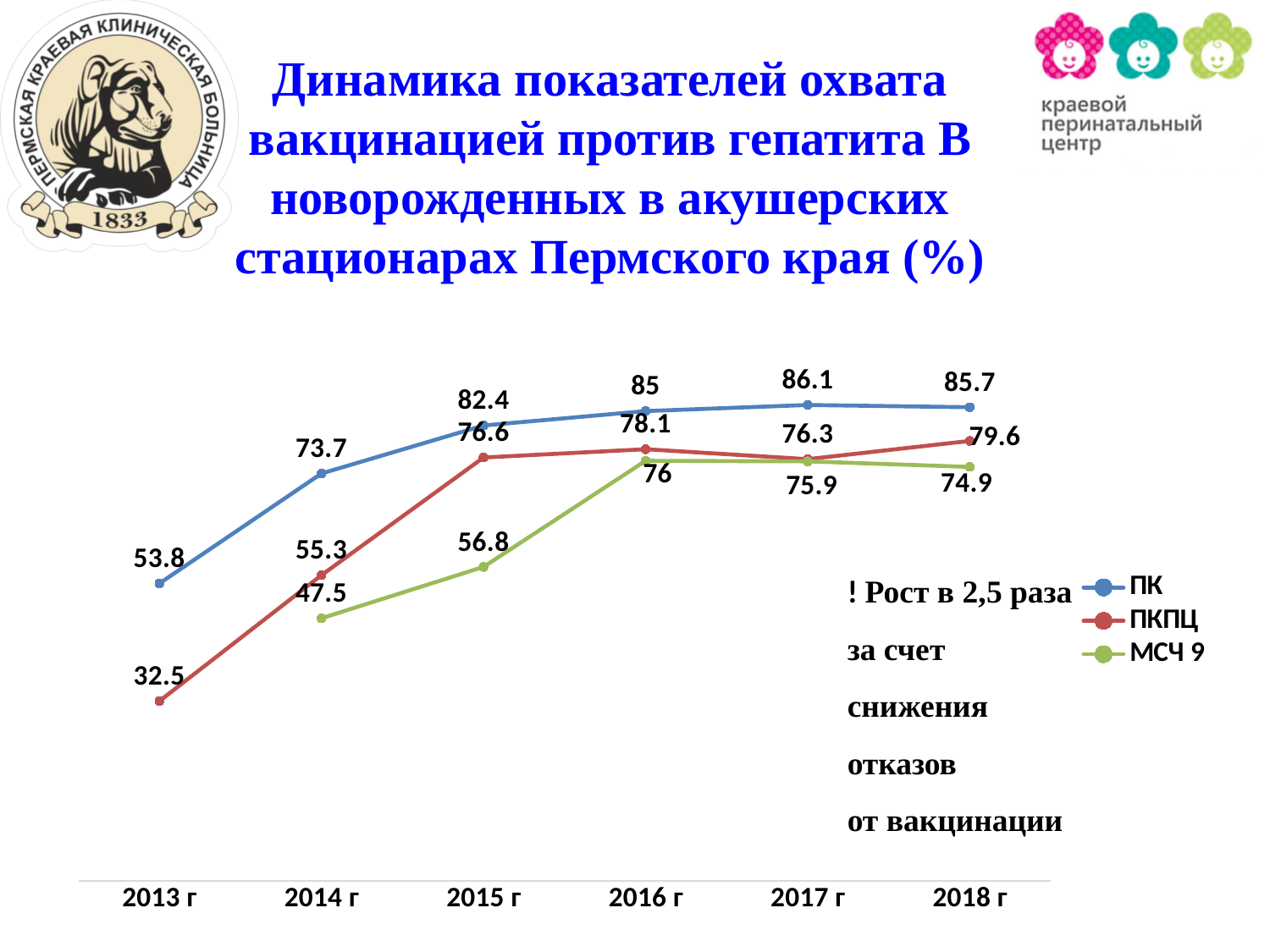
In which year does the ПК series reach its highest value? 2017 г Which series has the larger value in 2016 г, ПКПЦ or МСЧ 9? ПКПЦ Does the ПКПЦ series rise or fall from 2013 г to 2015 г? rise What is the value for МСЧ 9 in 2014 г? 47.5 In which year is the ПКПЦ series at its lowest value? 2013 г Which series is drawn in green in the legend? МСЧ 9 How many series does the legend list? 3 What is the value for ПКПЦ in 2018 г? 79.6 What is the value for ПК in 2013 г? 53.8 What is the difference between the ПК and ПКПЦ values in 2013 г? 21.3 What type of chart is shown on the slide? line chart How many years are shown on the x axis? 6